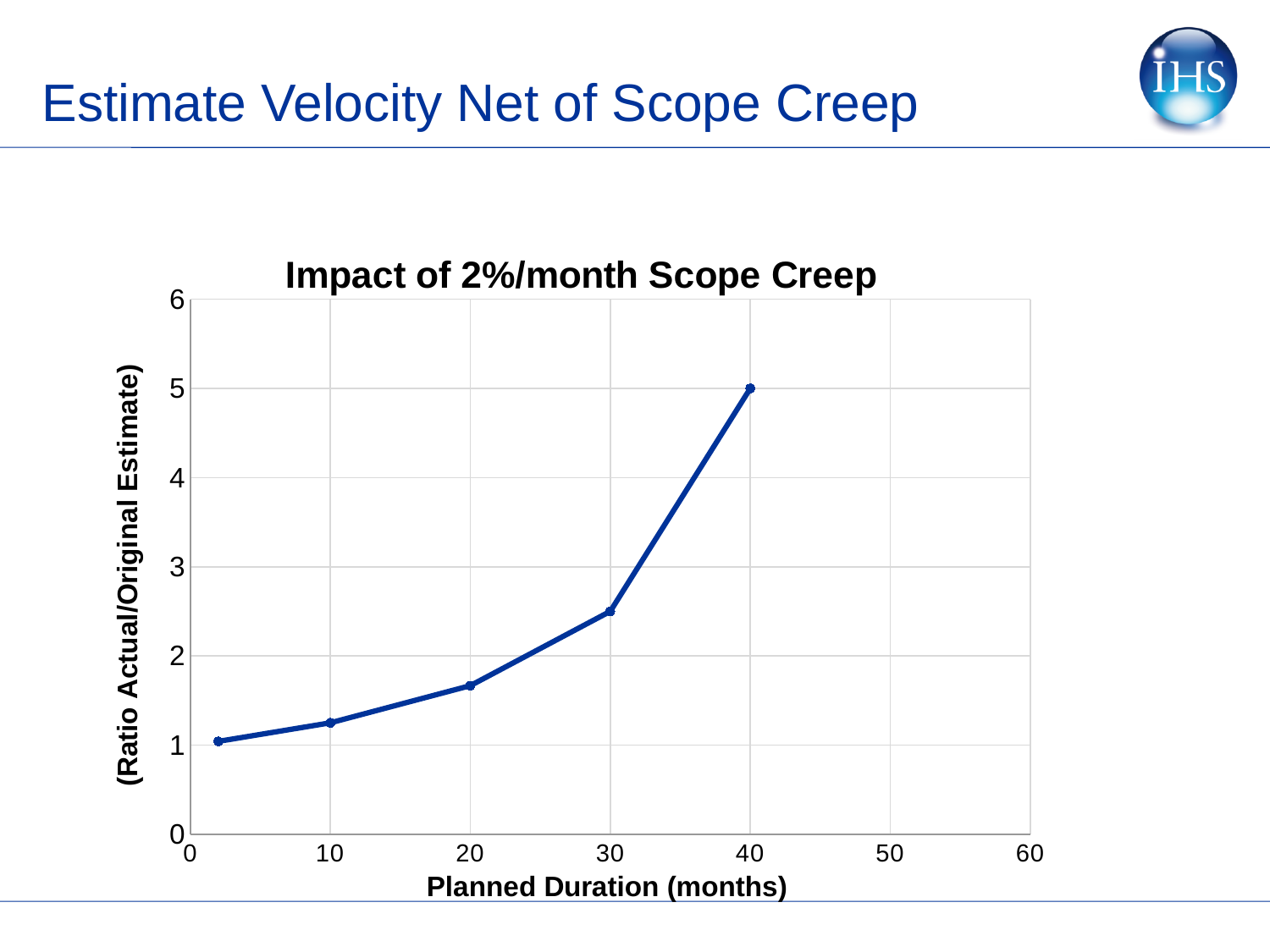
Which is larger, the ratio at 30 months or the ratio at 40 months? 40 months At which planned duration is the ratio highest? 40 months What is the ratio of actual to original estimate at a planned duration of 40 months? 5 What kind of chart is shown on the slide? line chart Is the value at a planned duration of 30 months greater or less than 2? greater What is the title of the chart? Impact of 2%/month Scope Creep How many data points are plotted on the line? 5 Is the value at a planned duration of 30 months greater or less than 3? less Does the ratio rise or fall as planned duration increases? rises Is the value at a planned duration of 10 months greater or less than 1? greater What is the label of the x axis? Planned Duration (months)